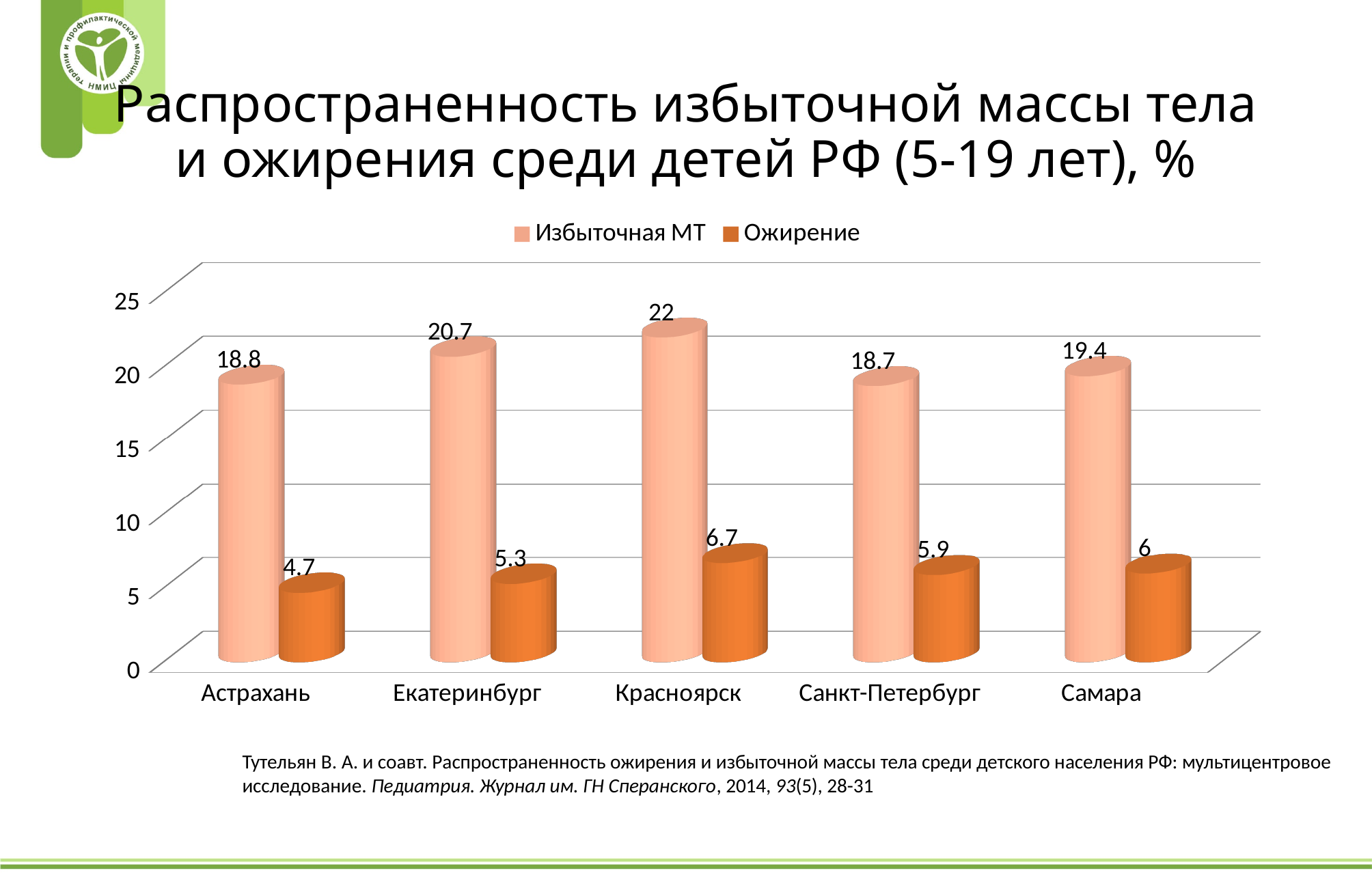
How many cities are shown on the x axis? 5 Which city has the lowest value for Избыточная МТ? Санкт-Петербург What is the value of Избыточная МТ for Красноярск? 22 What kind of chart is shown on the slide? bar chart Is the Избыточная МТ value for Екатеринбург greater or less than 20? greater What is the value of Избыточная МТ for Санкт-Петербург? 18.7 What is the value of Ожирение for Астрахань? 4.7 What is the difference between the Избыточная МТ values for Екатеринбург and Самара? 1.3 What are the two series named in the legend? Избыточная МТ and Ожирение Which city has the highest value for Ожирение? Красноярск Which is larger: the Ожирение value for Самара or for Екатеринбург? Самара How many series does the legend list? 2